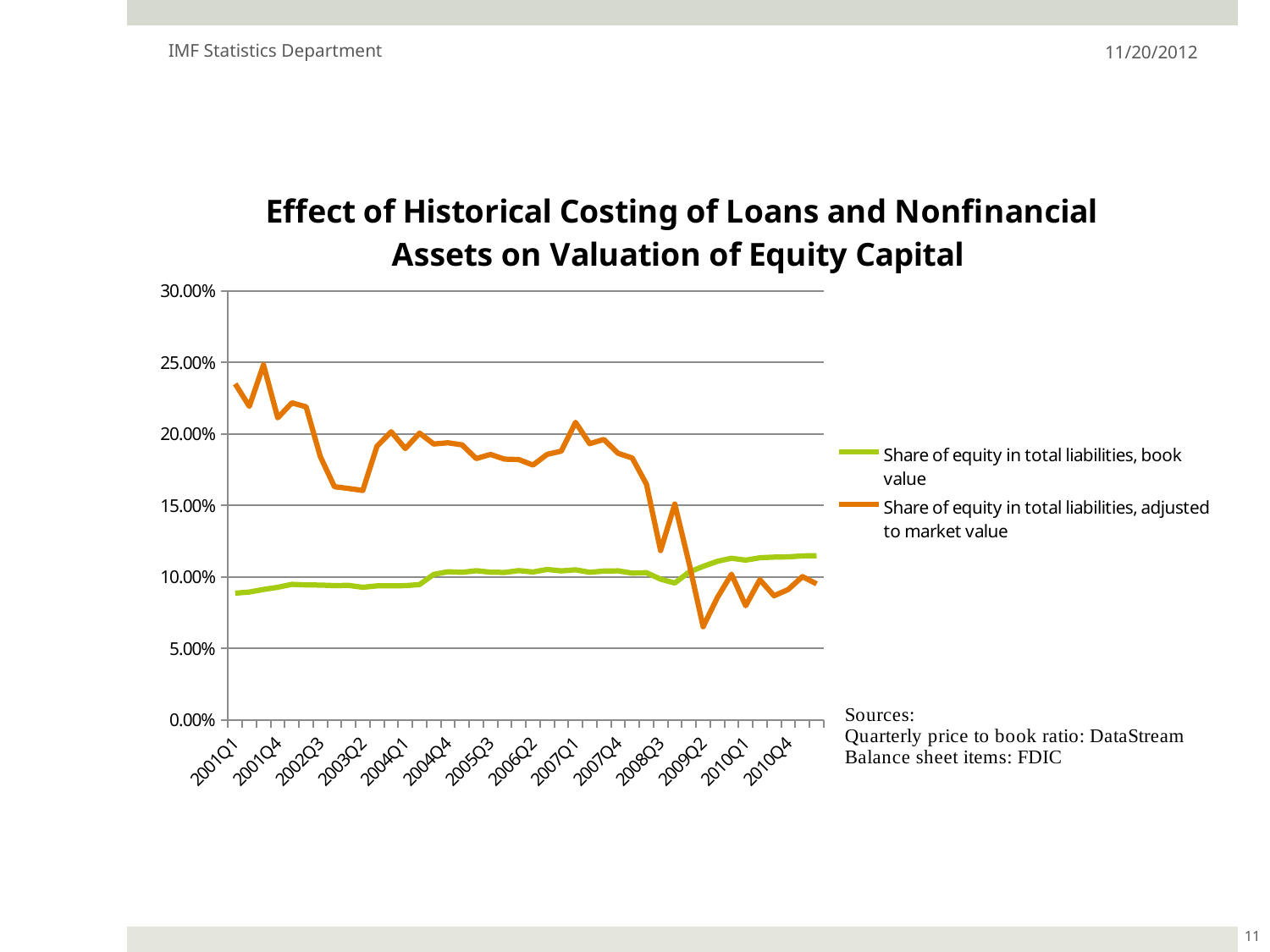
What colour is the line for 'Share of equity in total liabilities, book value'? Green What kind of chart is shown on the slide? Line chart Is the value for 'Share of equity in total liabilities, book value' at 2010Q4 greater or less than 10%? greater How many series does the legend list? 2 What is the title of the chart? Effect of Historical Costing of Loans and Nonfinancial Assets on Valuation of Equity Capital Is the value for 'Share of equity in total liabilities, book value' at 2001Q1 greater or less than 10%? less At 2001Q1, which series has the higher value: book value or adjusted to market value? Share of equity in total liabilities, adjusted to market value Is the value for 'Share of equity in total liabilities, adjusted to market value' at 2001Q1 greater or less than 20%? greater At 2010Q4, which series has the higher value: book value or adjusted to market value? Share of equity in total liabilities, book value Does the 'Share of equity in total liabilities, book value' series generally rise or fall from 2001Q1 to 2010Q4? Rise